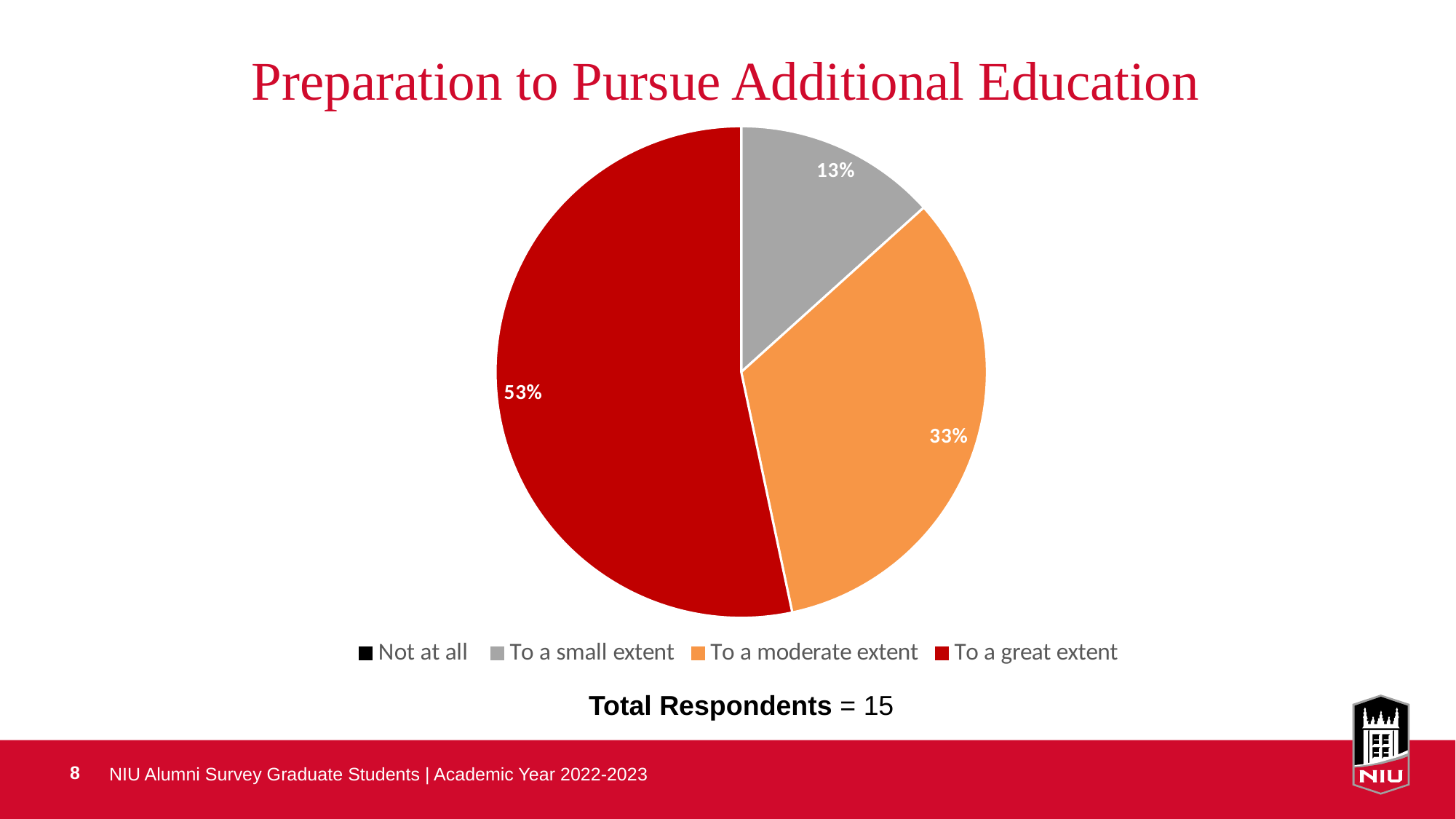
What is the difference in percentage points between "To a great extent" and "To a moderate extent"? 20 What is the difference in percentage points between "To a moderate extent" and "To a small extent"? 20 What kind of chart is shown on the slide? pie chart What share of respondents answered "To a moderate extent"? 33% Which is larger, the share for "To a moderate extent" or the share for "To a small extent"? To a moderate extent What share of respondents answered "To a small extent"? 13% How many categories does the legend list? 4 Which response category with a visible slice has the smallest share of the pie? To a small extent Which response category has the largest share of the pie? To a great extent What is the title of the chart? Preparation to Pursue Additional Education What share of respondents answered "To a great extent"? 53% What colour is the slice for "To a moderate extent"? orange